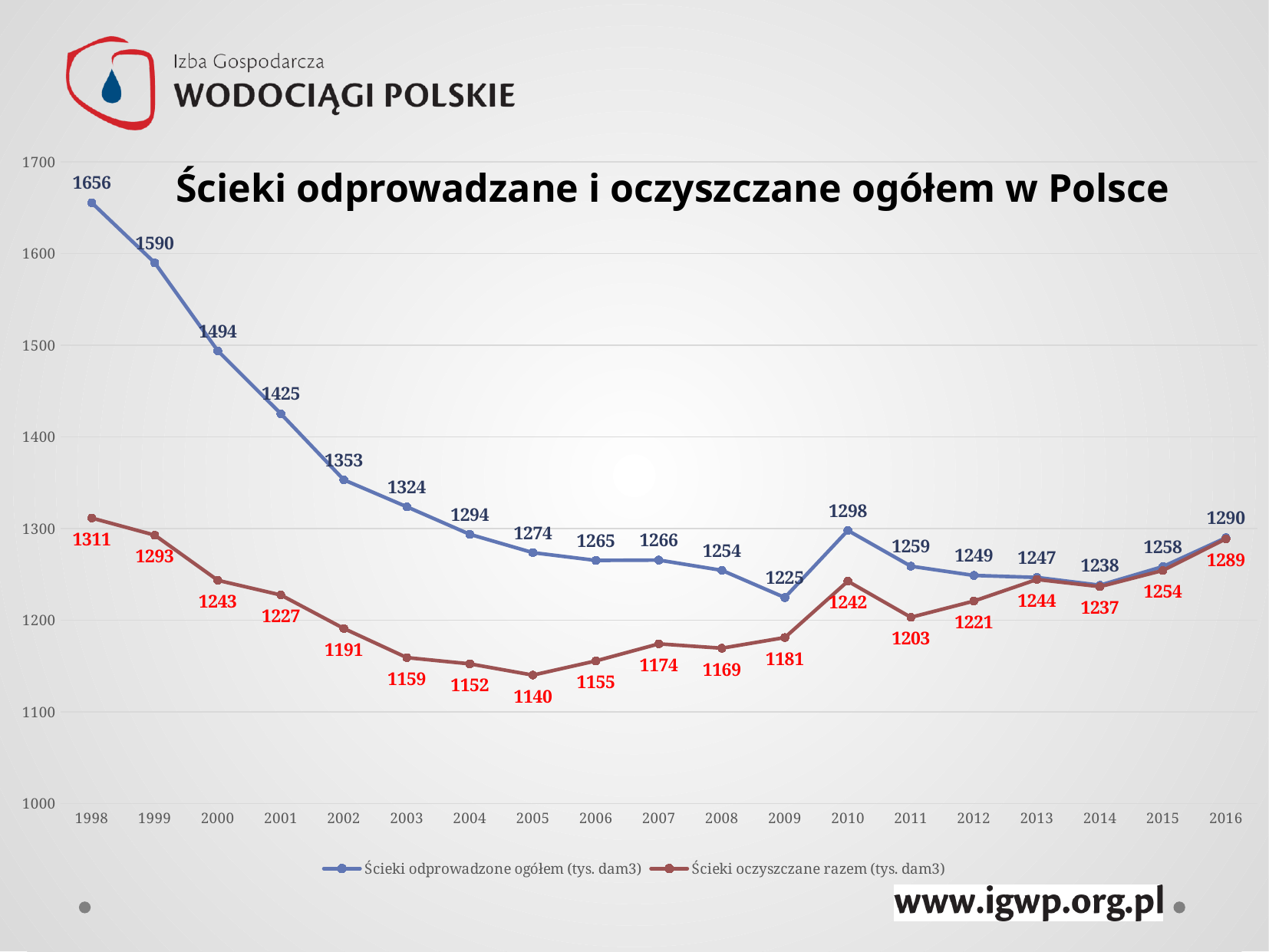
What is the difference between Ścieki odprowadzone ogółem in 1998 and in 1999? 66 What is the title of the chart? Ścieki odprowadzane i oczyszczane ogółem w Polsce What is the difference between Ścieki odprowadzone ogółem and Ścieki oczyszczane razem in 2016? 1 What is the value of Ścieki oczyszczane razem (tys. dam3) in 2016? 1289 What kind of chart is shown on the slide? line chart In which year is Ścieki oczyszczane razem (tys. dam3) highest? 1998 In which year is Ścieki odprowadzone ogółem (tys. dam3) lowest? 2009 How many series does the legend list? 2 What is the value of Ścieki odprowadzone ogółem (tys. dam3) in 1998? 1656 How many years are shown on the x axis? 19 Which is larger in 2003: Ścieki odprowadzone ogółem or Ścieki oczyszczane razem? Ścieki odprowadzone ogółem What is the value of Ścieki oczyszczane razem (tys. dam3) in 2005? 1140